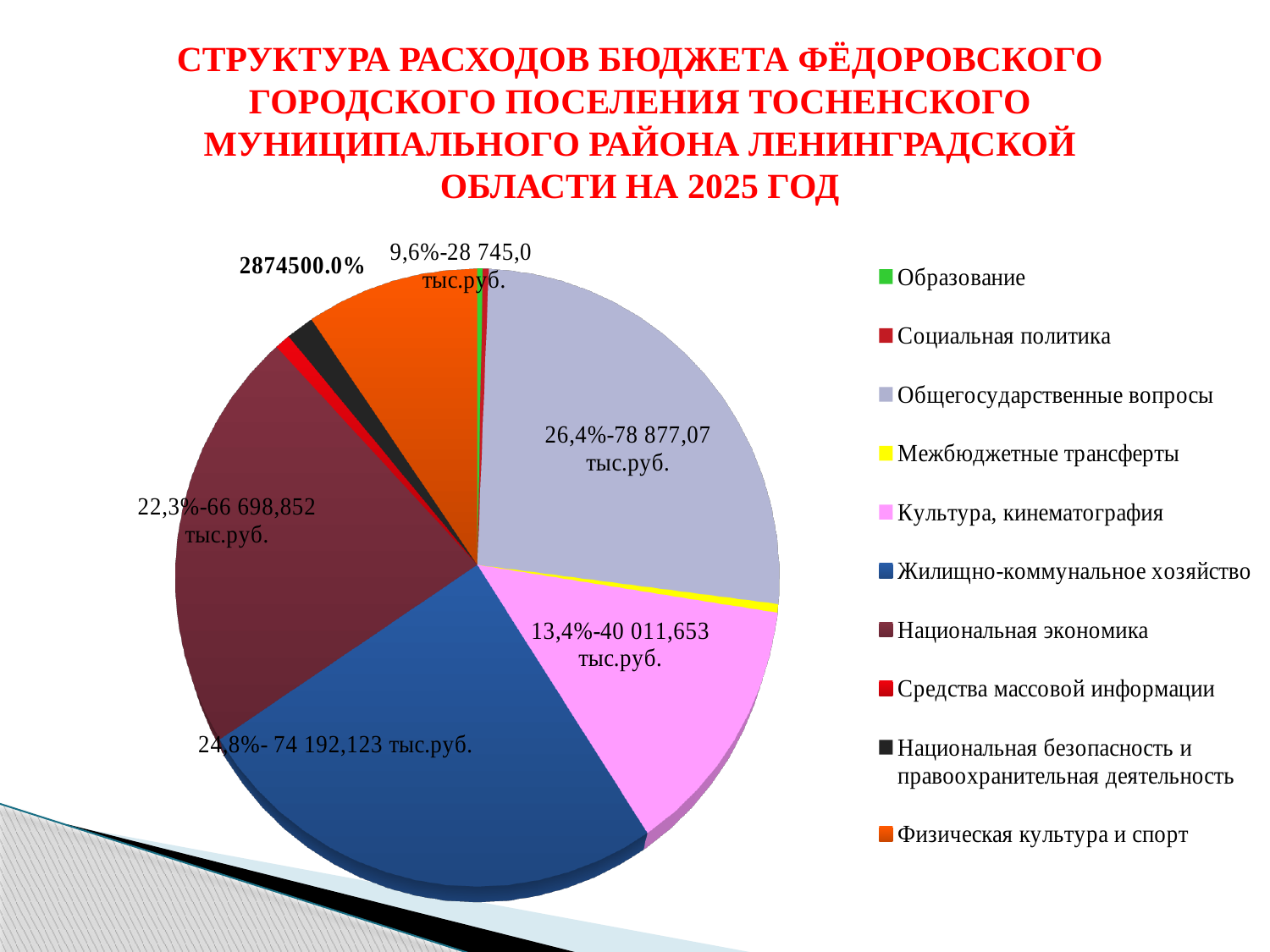
What amount in тыс.руб. is shown for Национальная экономика? 66 698,852 тыс.руб. What share of the budget expenditure goes to Культура, кинематография? 13,4% What amount in тыс.руб. is shown for Физическая культура и спорт? 28 745,0 тыс.руб. How many categories does the legend of the pie chart list? 10 Which colour represents Физическая культура и спорт in the legend? orange What is the difference in percentage points between the share for Общегосударственные вопросы and the share for Культура, кинематография? 13 percentage points Which is larger: the share for Жилищно-коммунальное хозяйство or the share for Национальная экономика? Жилищно-коммунальное хозяйство What share of the budget expenditure goes to Общегосударственные вопросы? 26,4% What amount in тыс.руб. is shown for Общегосударственные вопросы? 78 877,07 тыс.руб. What share of the budget expenditure goes to Жилищно-коммунальное хозяйство? 24,8% What kind of chart is shown on the slide? pie chart Which category has the largest share of the budget expenditure? Общегосударственные вопросы